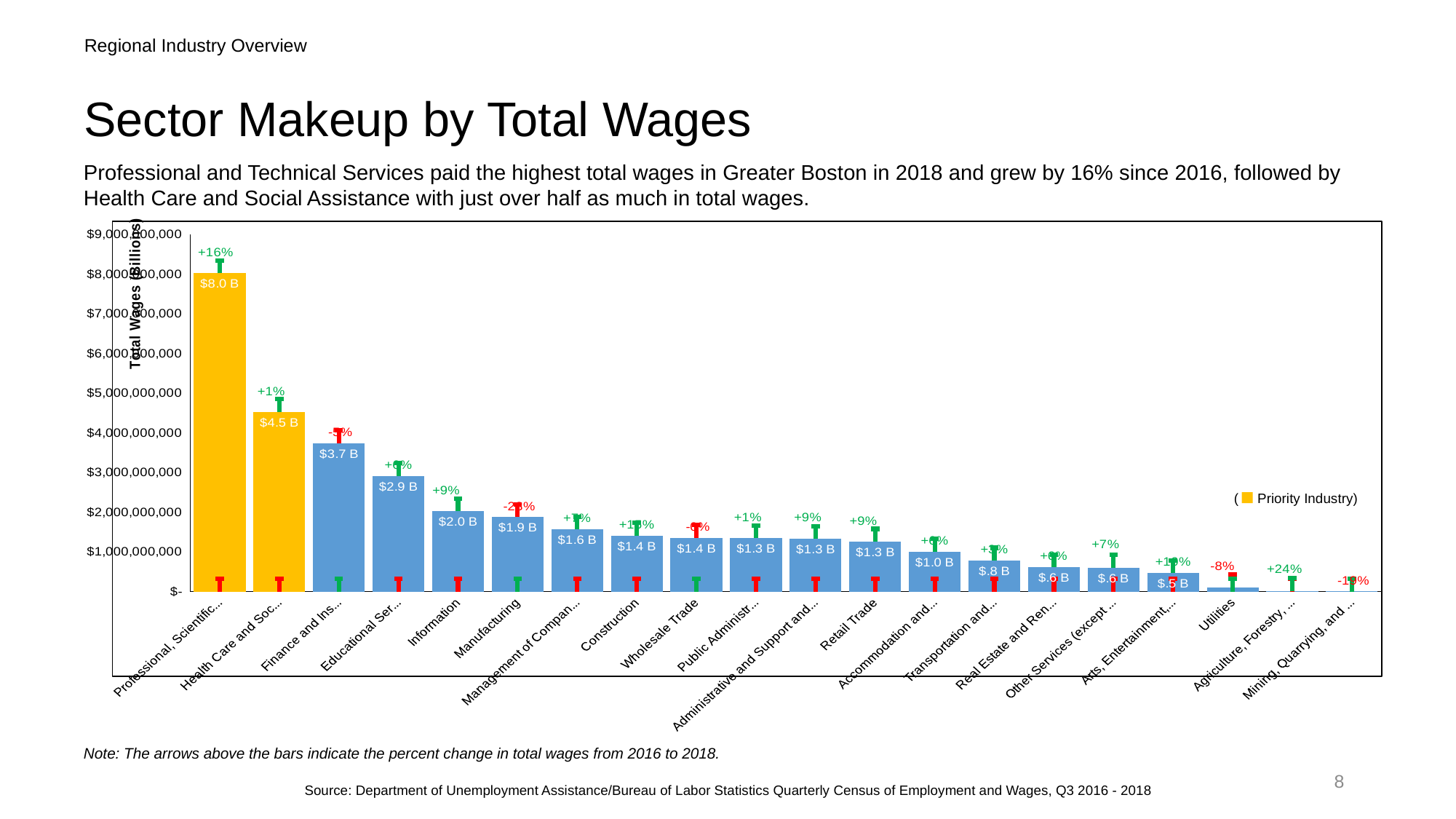
What is the total wages value for Information? $2.0 B What percent change is shown above the Professional, Scientific... bar? +16% Is the total wages value for Utilities greater or less than $1,000,000,000? less Do the bar values rise or fall moving from left to right along the x axis? fall What is the total wages value for Retail Trade? $1.3 B What is the total wages value for Professional, Scientific...? $8.0 B What kind of chart is shown on the slide? bar chart How many sectors are shown on the x axis? 20 Which sector has the highest total wages? Professional, Scientific... Which has higher total wages, Finance and Ins... or Educational Ser...? Finance and Ins... What is the difference in total wages between Professional, Scientific... and Health Care and Soc...? $3.5 B What is the total wages value for Health Care and Soc...? $4.5 B